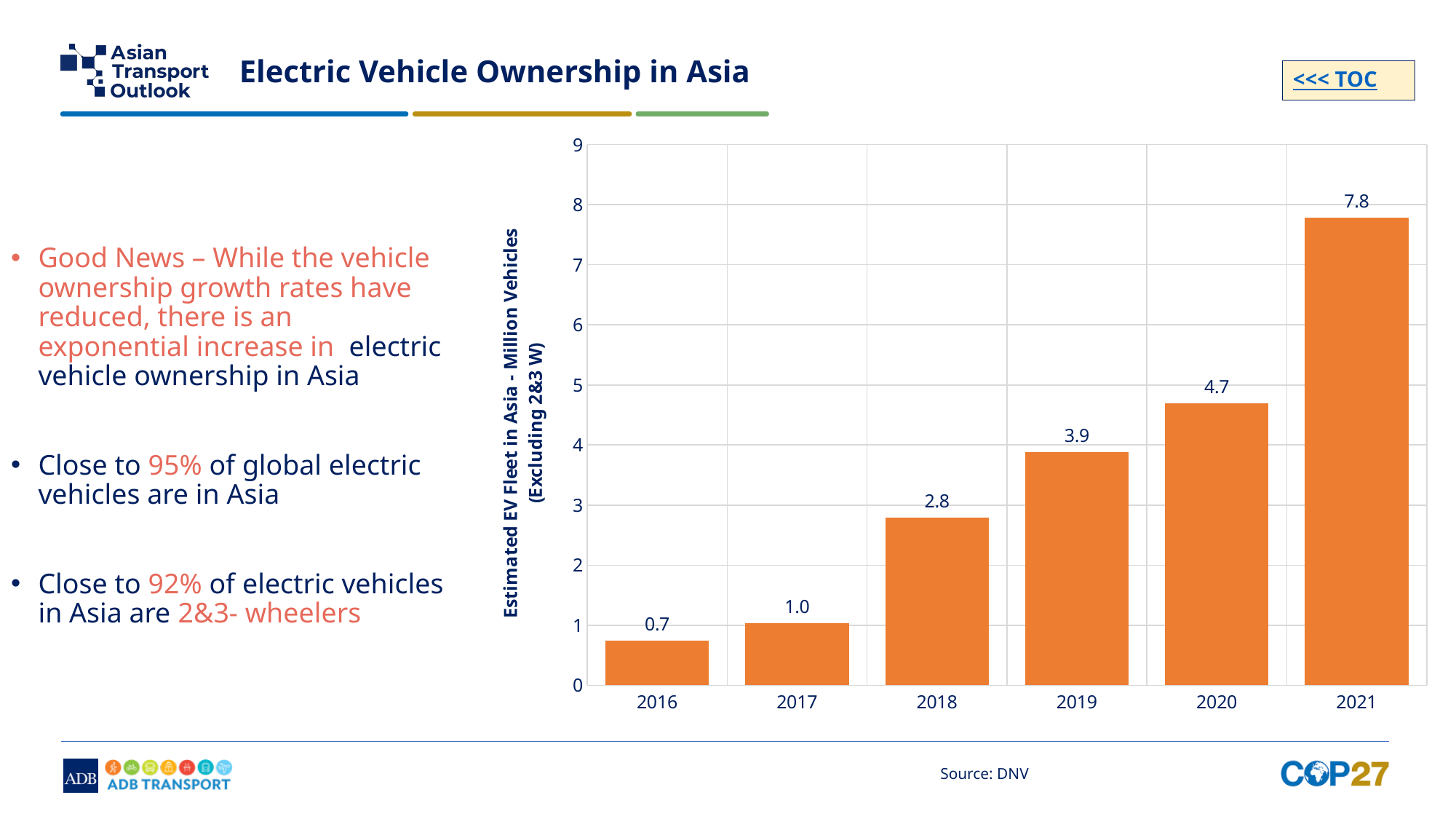
Is the value for 2020 greater or less than 4? greater What is the difference between the estimated EV fleet in 2018 and in 2017? 1.8 What is the estimated EV fleet in Asia for 2021? 7.8 What kind of chart is shown on the slide? Bar chart How many years are shown on the x axis of the chart? 6 Which year has a larger estimated EV fleet, 2019 or 2020? 2020 What is the estimated EV fleet in Asia for 2019? 3.9 Do the values rise or fall from 2016 to 2021? Rise Which year has the highest estimated EV fleet in Asia? 2021 What is the estimated EV fleet in Asia for 2016? 0.7 Which year has the lowest estimated EV fleet in Asia? 2016 What is the difference between the estimated EV fleet in 2021 and in 2020? 3.1